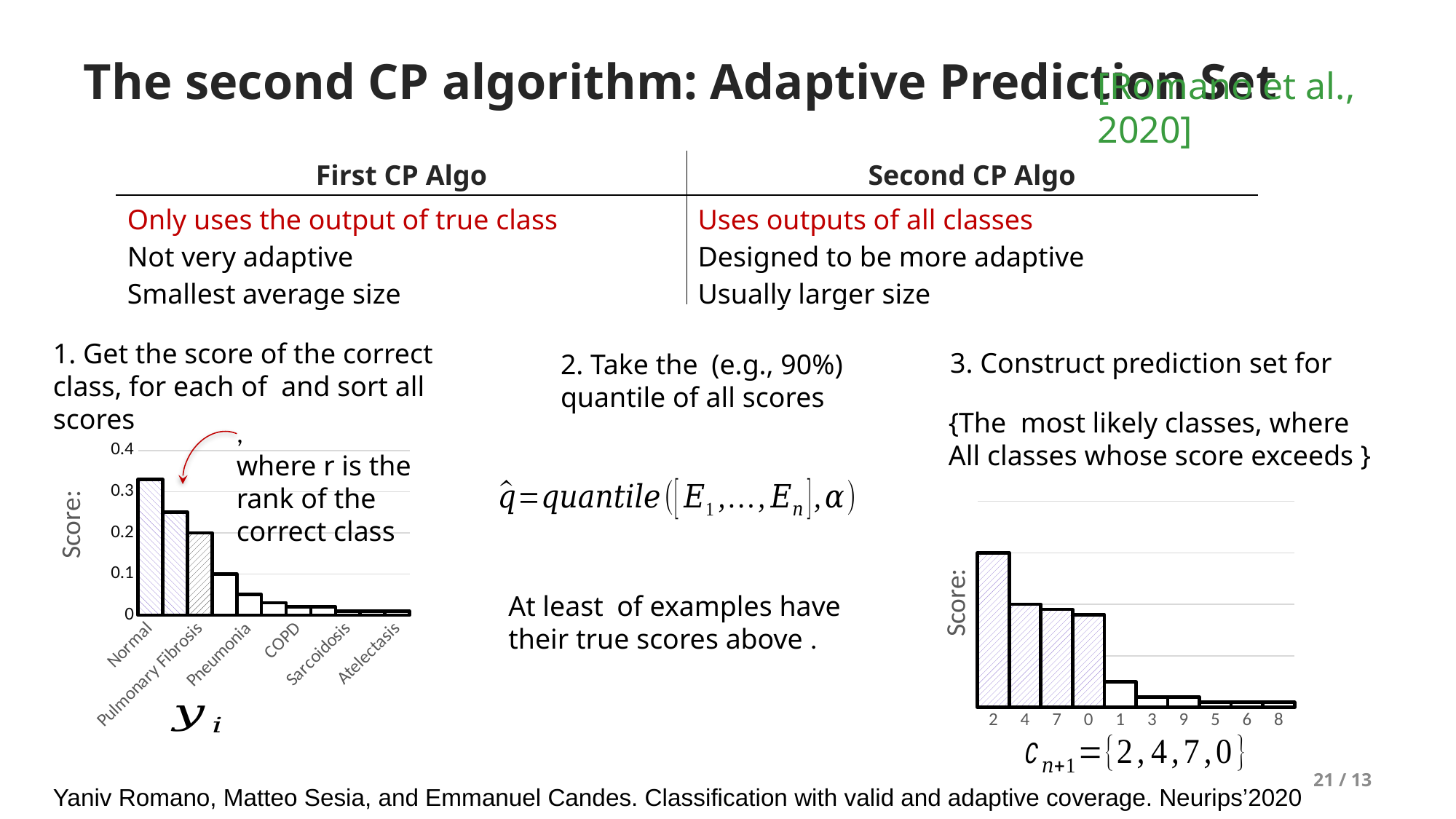
In the left chart, is the score for Normal greater or less than 0.3? greater In the left chart, is the score for Pulmonary Fibrosis greater or less than 0.3? less In the left chart, do the scores rise or fall from left to right along the x axis? fall In the right chart, which category has the highest score? 2 In the right chart, what is the label of the first category on the x axis? 2 In the left chart, what is the label on the vertical axis? Score In the left chart, which has a higher score, Normal or Pulmonary Fibrosis? Normal What kind of chart is the chart on the left of the slide (with categories Normal, Pulmonary Fibrosis, Pneumonia)? bar chart What kind of chart is the chart on the right of the slide? bar chart How many bars are in the chart on the right of the slide (with categories 2, 4, 7, 0, ...)? 10 In the left chart, which category has the highest score? Normal In the right chart, which has a higher score, category 4 or category 1? 4